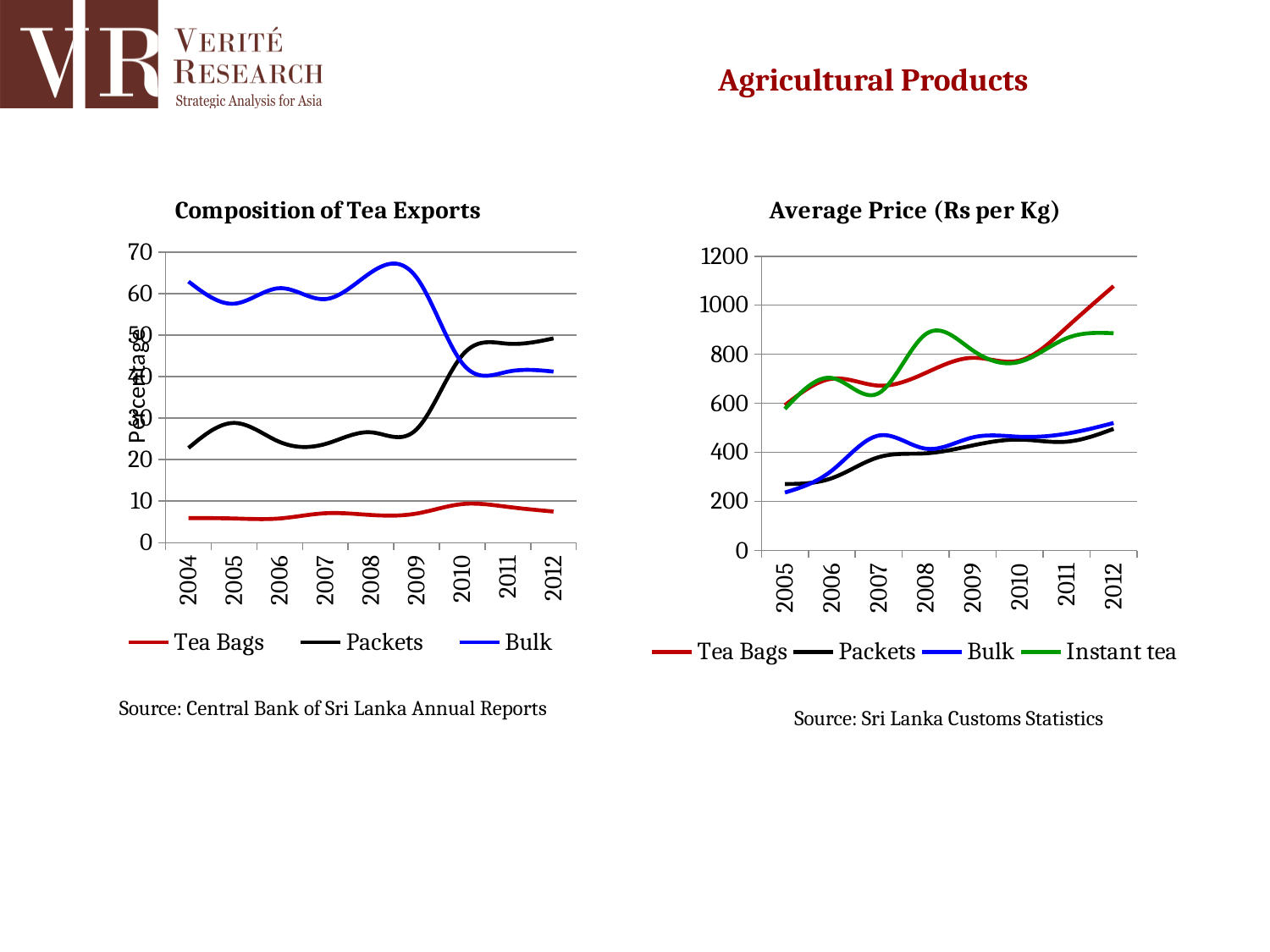
How many years are shown on the x axis of the "Composition of Tea Exports" chart? 9 In the "Composition of Tea Exports" chart, which is larger in 2012, Packets or Bulk? Packets How many years are shown on the x axis of the "Average Price (Rs per Kg)" chart? 8 How many series does the legend of the "Average Price (Rs per Kg)" chart list? 4 In the "Composition of Tea Exports" chart, does the Bulk series rise or fall from 2004 to 2012? fall What colour is the Instant tea line in the "Average Price (Rs per Kg)" chart? green In the "Average Price (Rs per Kg)" chart, which series has the highest value in 2012? Tea Bags In the "Average Price (Rs per Kg)" chart, is the value for Tea Bags in 2012 greater or less than 1000? greater In the "Average Price (Rs per Kg)" chart, is the value for Packets in 2005 greater or less than 400? less In the "Composition of Tea Exports" chart, is the value for Bulk in 2004 greater or less than 60? greater How many series does the legend of the "Composition of Tea Exports" chart list? 3 What kind of chart is the "Composition of Tea Exports" chart? line chart